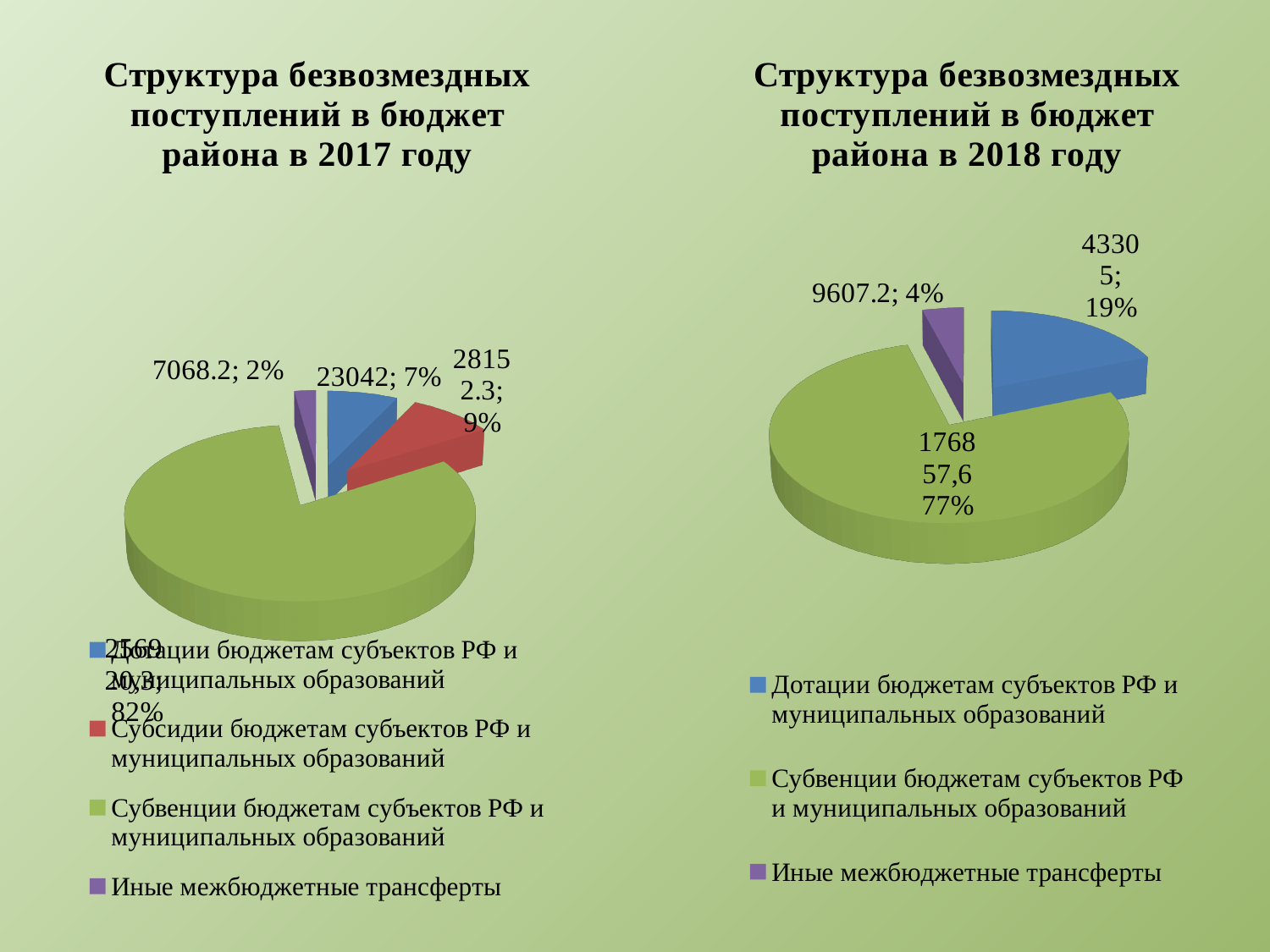
In the 2017 chart, what value is labelled for 'Дотации бюджетам субъектов РФ и муниципальных образований'? 23042; 7% In the 2017 chart, which category has the smallest slice? Иные межбюджетные трансферты In the 2018 chart, which category has the largest slice? Субвенции бюджетам субъектов РФ и муниципальных образований How many slices does the 2018 chart have? 3 In the 2017 chart, what value is labelled for 'Иные межбюджетные трансферты'? 7068.2; 2% In the 2018 chart, what share of the pie is 'Субвенции бюджетам субъектов РФ и муниципальных образований'? 77% In the 2018 chart, what value is labelled for 'Иные межбюджетные трансферты'? 9607.2; 4% In the 2017 chart, what share of the pie is 'Субсидии бюджетам субъектов РФ и муниципальных образований'? 9% What kind of chart is used on the left, 'Структура безвозмездных поступлений в бюджет района в 2017 году'? pie chart How many entries does the legend of the 2017 chart list? 4 In the 2018 chart, what share of the pie is 'Дотации бюджетам субъектов РФ и муниципальных образований'? 19%